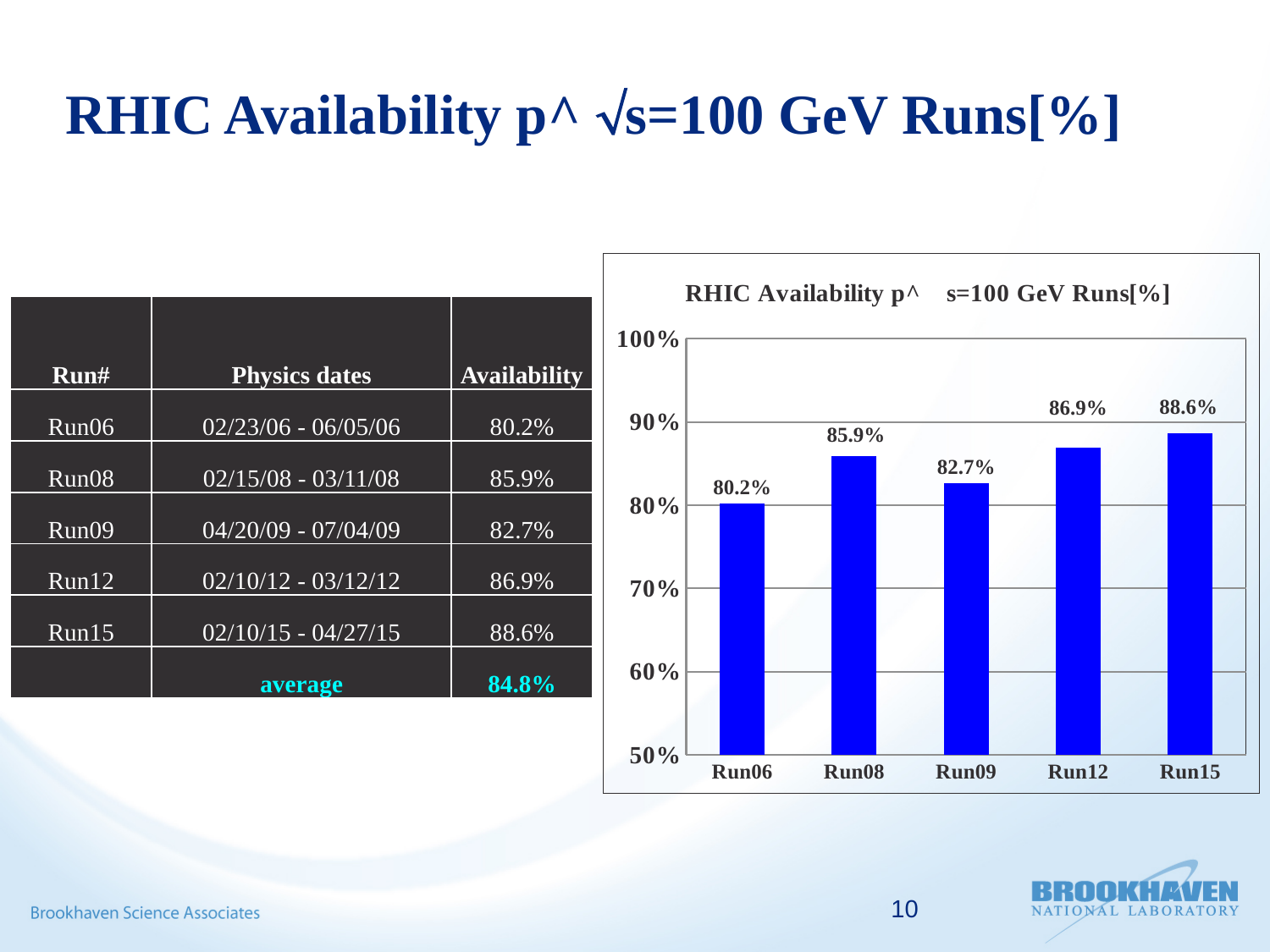
What is the difference between the availability of Run08 and Run09? 3.2% How many runs are plotted in the chart? 5 What is the lowest value shown on the chart's vertical axis? 50% Which run has the highest availability in the chart? Run15 What is the availability value shown for Run12? 86.9% What is the availability value shown for Run06? 80.2% Is the value for Run09 greater or less than 80%? greater Which has a higher availability, Run08 or Run09? Run08 What colour are the bars in the chart? blue What kind of chart is shown on the slide? bar chart Which run has the lowest availability in the chart? Run06 What is the difference between the availability of Run15 and Run06? 8.4%